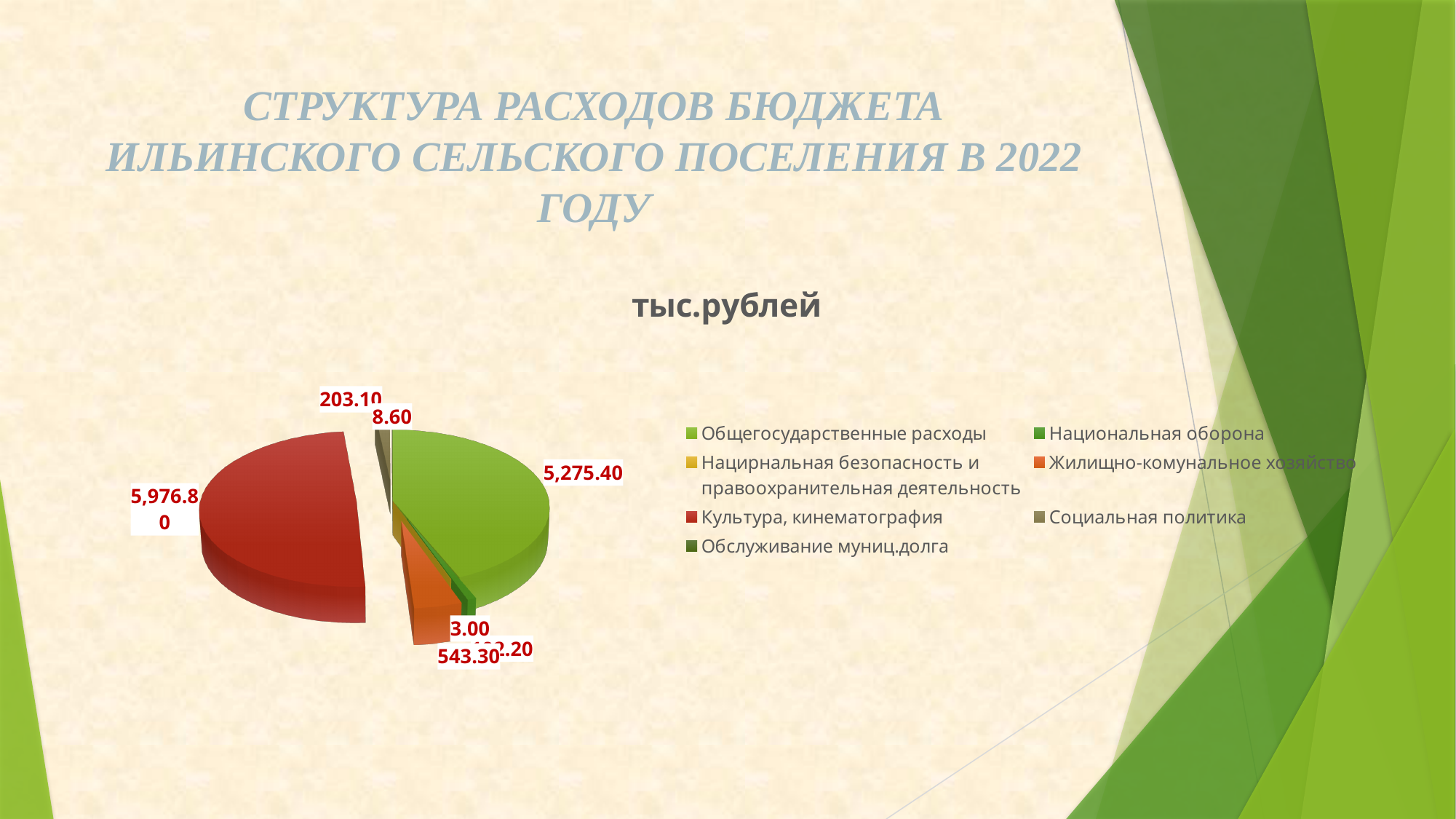
What is the difference between the values for Социальная политика and Обслуживание муниц.долга? 194.50 What value is shown for Жилищно-комунальное хозяйство in the pie chart? 543.30 How many categories does the legend of the pie chart list? 7 What kind of chart is shown on the slide? Pie chart What value is shown for Общегосударственные расходы in the pie chart? 5,275.40 Which is larger: Культура, кинематография or Общегосударственные расходы? Культура, кинематография What is the difference between the values for Культура, кинематография and Общегосударственные расходы? 701.40 What value is shown for Культура, кинематография in the pie chart? 5,976.80 What value is shown for Обслуживание муниц.долга in the pie chart? 8.60 What value is shown for Социальная политика in the pie chart? 203.10 Which category has the largest slice in the pie chart? Культура, кинематография What is the title shown above the pie chart? тыс.рублей